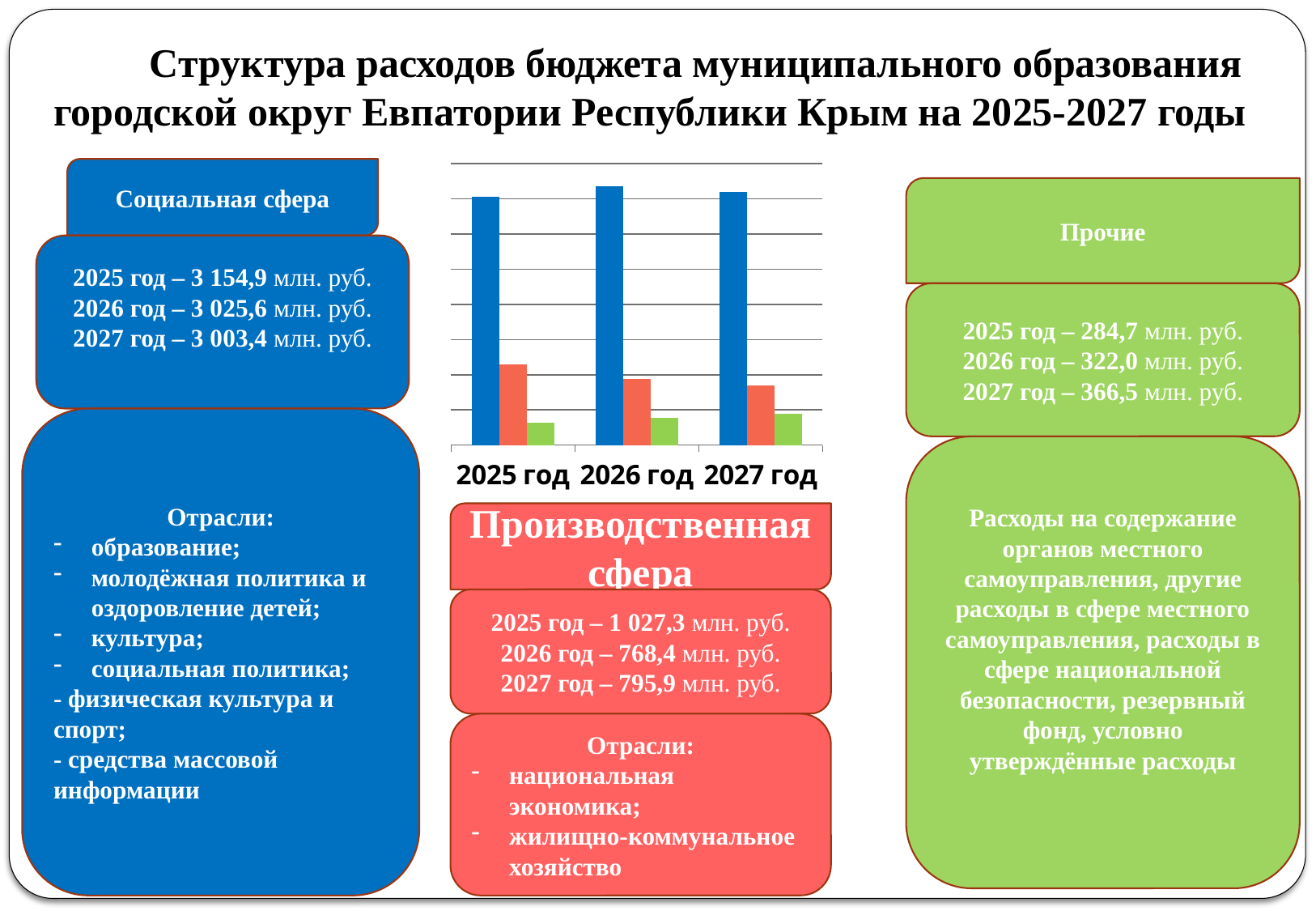
Do the green bars rise or fall from 2025 год to 2027 год? rise By how much does the Прочие expenditure for 2027 год exceed that for 2025 год, according to the slide? 81,8 млн. руб. Which coloured bar is the tallest in every year group on the chart? blue What kind of chart is shown on the slide? bar chart According to the slide, what is the Производственная сфера expenditure for 2026 год? 768,4 млн. руб. According to the slide, what is the Прочие expenditure for 2027 год? 366,5 млн. руб. Which coloured bar is the shortest in every year group on the chart? green According to the slide, what is the Социальная сфера expenditure for 2025 год? 3 154,9 млн. руб. How many categories are shown on the x axis of the chart? 3 Is the green bar taller for 2027 год or for 2025 год? 2027 год How many bars are plotted for each year on the chart? 3 Is the red bar taller for 2025 год or for 2026 год? 2025 год